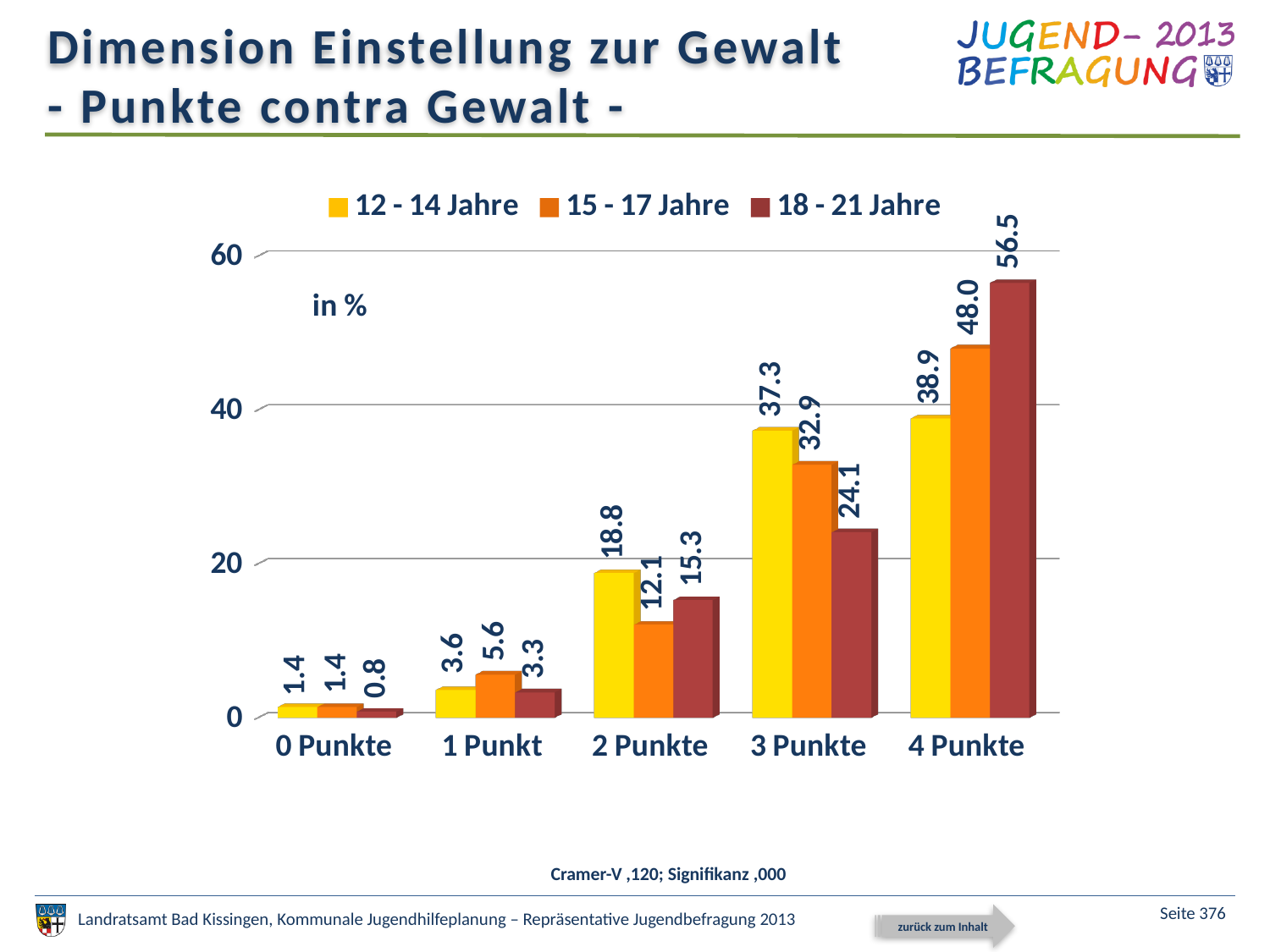
What kind of chart is shown on the slide? bar chart How many categories are shown on the x axis? 5 What is the difference between the 18 - 21 Jahre and 12 - 14 Jahre values at 4 Punkte? 17.6 What is the value for 18 - 21 Jahre at 4 Punkte? 56.5 Do the values for 12 - 14 Jahre rise or fall from 0 Punkte to 4 Punkte? rise Which category has the highest value for the 18 - 21 Jahre series? 4 Punkte What is the value for 12 - 14 Jahre at 3 Punkte? 37.3 Which category has the lowest value for the 15 - 17 Jahre series? 0 Punkte Is the value for 15 - 17 Jahre at 4 Punkte greater or less than 40? greater At 3 Punkte, which series has the larger value: 12 - 14 Jahre or 18 - 21 Jahre? 12 - 14 Jahre What is the value for 15 - 17 Jahre at 2 Punkte? 12.1 How many series does the legend list? 3